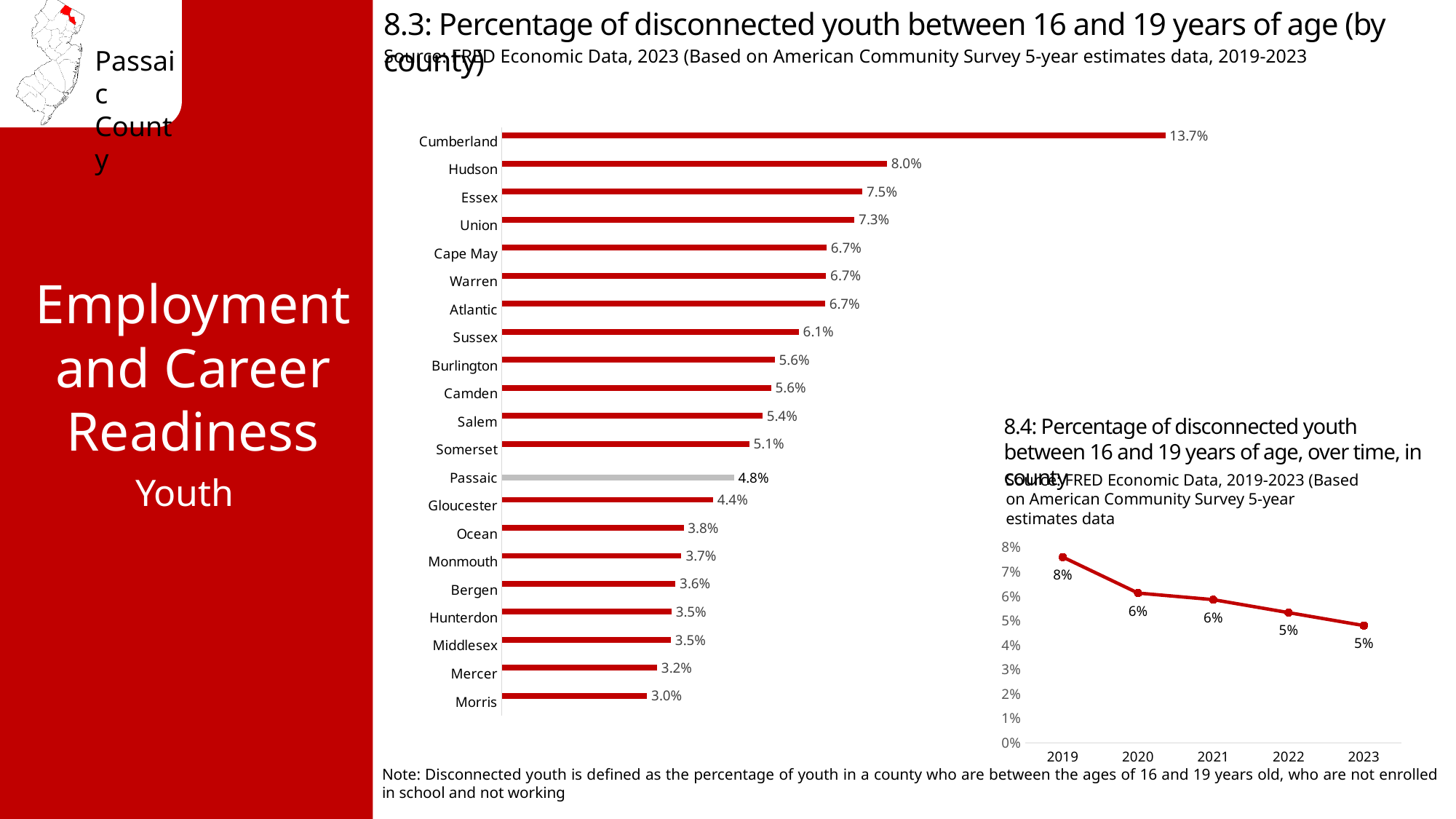
What kind of chart is chart 8.3 (percentage of disconnected youth by county)? Bar chart In chart 8.4 (percentage of disconnected youth over time), do the values rise or fall from 2019 to 2023? Fall In chart 8.3 (percentage of disconnected youth by county), which county has the highest value? Cumberland In chart 8.3 (percentage of disconnected youth by county), which is larger, the value for Essex or the value for Union? Essex In chart 8.4 (percentage of disconnected youth over time), how many years are plotted? 5 In chart 8.3 (percentage of disconnected youth by county), which county has the lowest value? Morris In chart 8.3 (percentage of disconnected youth by county), what is the value for Passaic? 4.8% In chart 8.3 (percentage of disconnected youth by county), what is the difference between Cumberland and Hudson? 5.7% In chart 8.3 (percentage of disconnected youth by county), which county's bar is shown in grey rather than red? Passaic In chart 8.4 (percentage of disconnected youth over time), what is the value for 2019? 8% In chart 8.3 (percentage of disconnected youth by county), what is the value for Hudson? 8.0% In chart 8.3 (percentage of disconnected youth by county), how many counties are shown? 21